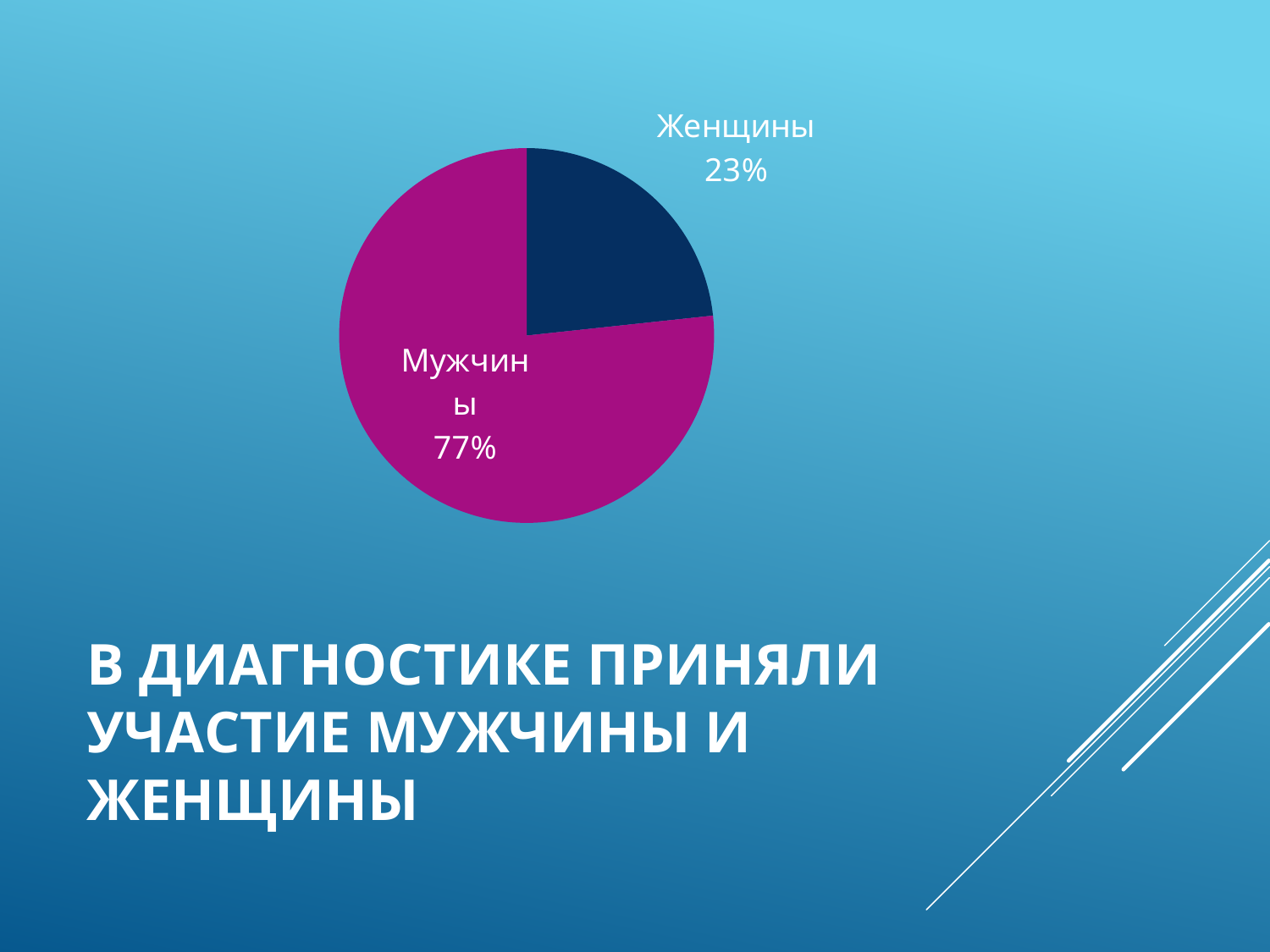
Which slice of the pie is the largest? Мужчины What kind of chart is shown on the slide? pie chart What is the difference in percentage points between the Мужчины and Женщины slices? 54 Which slice of the pie is the smallest? Женщины How many slices does the pie chart have? 2 What share of the pie is labelled Мужчины? 77% What colour is the Женщины slice? dark blue What share of the pie is labelled Женщины? 23% Which slice is larger, Мужчины or Женщины? Мужчины What colour is the Мужчины slice? magenta